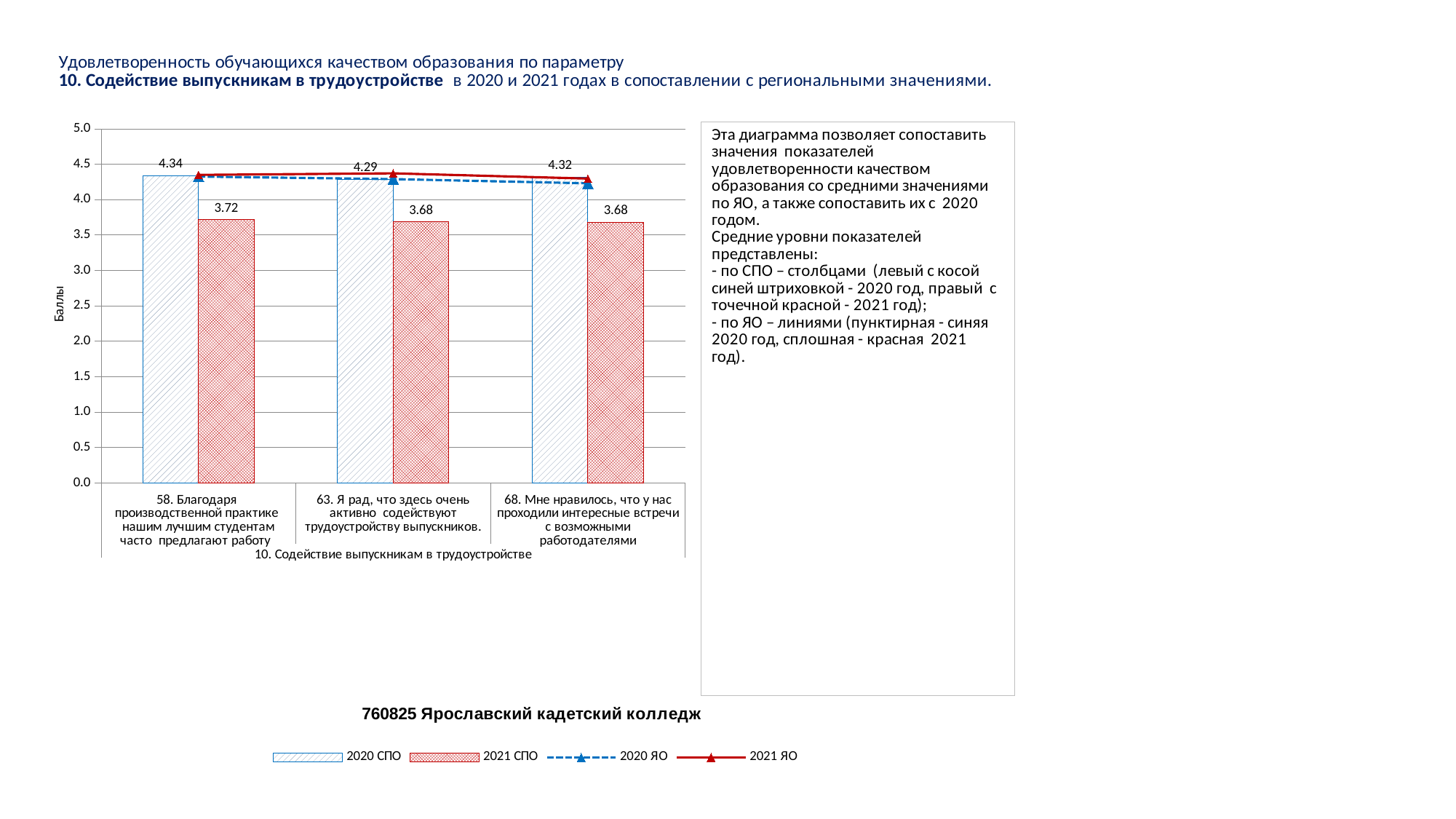
Which category has the highest 2020 СПО value? 58. Благодаря производственной практике нашим лучшим студентам часто предлагают работу How many series does the legend list? 4 What is the label of the vertical axis? Баллы How many categories are shown on the x axis? 3 Is the 2021 ЯО value for category 58 greater or less than 4.0? greater What is the 2021 СПО value for category 63 (Я рад, что здесь очень активно содействуют трудоустройству выпускников)? 3.68 For category 68, which is larger: the 2020 СПО value or the 2021 СПО value? 2020 СПО What is the 2020 СПО value for category 68 (Мне нравилось, что у нас проходили интересные встречи с возможными работодателями)? 4.32 What is the difference between the 2020 СПО and 2021 СПО values for category 58? 0.62 What is the 2021 СПО value for category 58? 3.72 Which category has the lowest 2020 СПО value? 63. Я рад, что здесь очень активно содействуют трудоустройству выпускников. What is the 2020 СПО value for category 58 (Благодаря производственной практике нашим лучшим студентам часто предлагают работу)? 4.34